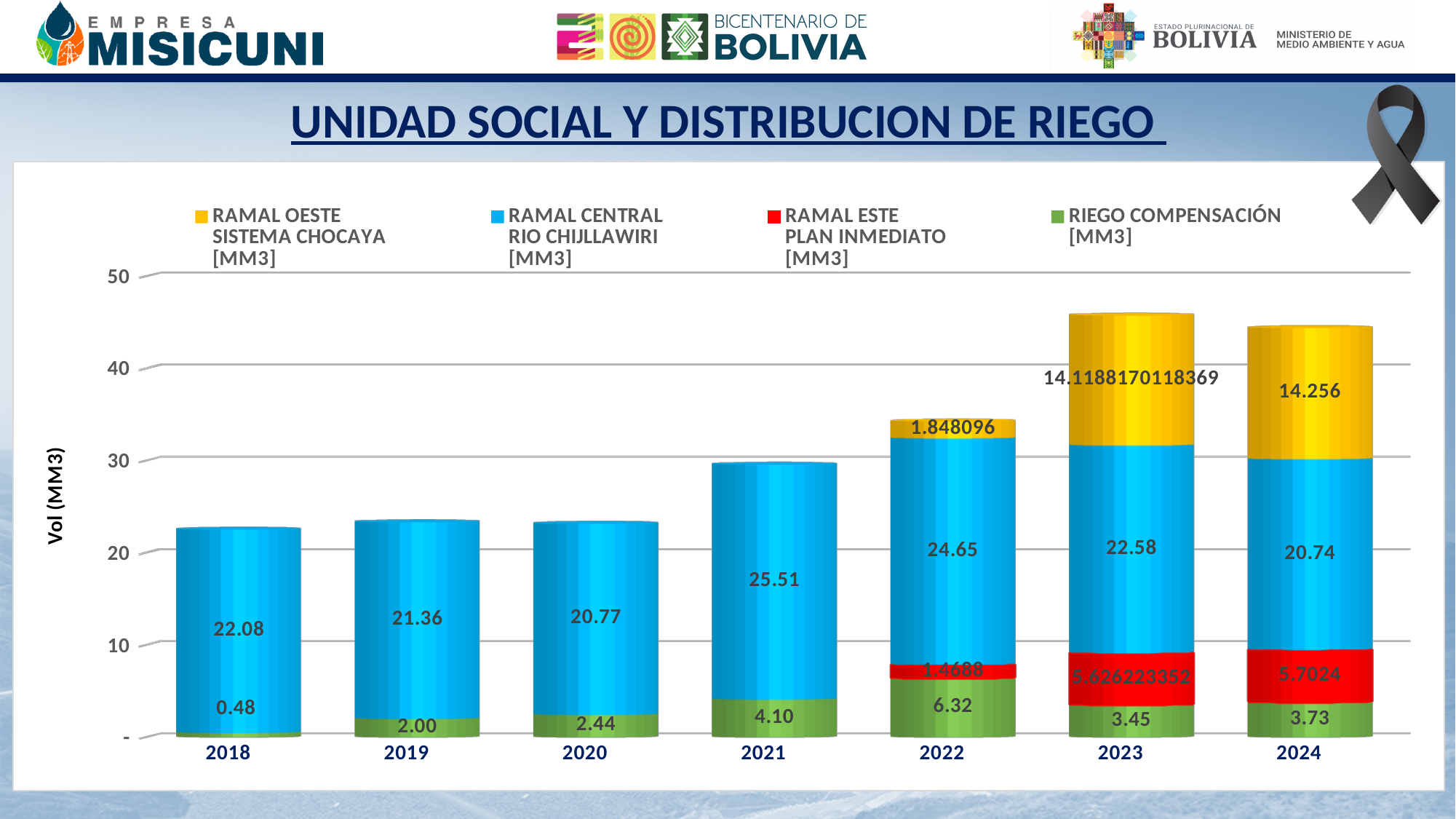
What is the value of RAMAL ESTE PLAN INMEDIATO [MM3] in 2022? 1.4688 Which is larger: RIEGO COMPENSACIÓN [MM3] in 2022 or in 2021? 2022 What is the total of the stacked bar for 2019? 23.36 What is the difference between the RAMAL CENTRAL RIO CHIJLLAWIRI [MM3] values for 2018 and 2024? 1.34 What is the value of RAMAL OESTE SISTEMA CHOCAYA [MM3] in 2024? 14.256 In which year is the RAMAL CENTRAL RIO CHIJLLAWIRI [MM3] value highest? 2021 What is the value of RIEGO COMPENSACIÓN [MM3] in 2018? 0.48 What is the value of RAMAL CENTRAL RIO CHIJLLAWIRI [MM3] in 2021? 25.51 Is the total stacked value for 2021 greater or less than 20? greater In which year is the RIEGO COMPENSACIÓN [MM3] value lowest? 2018 How many series does the legend list? 4 How many years are shown on the x axis? 7